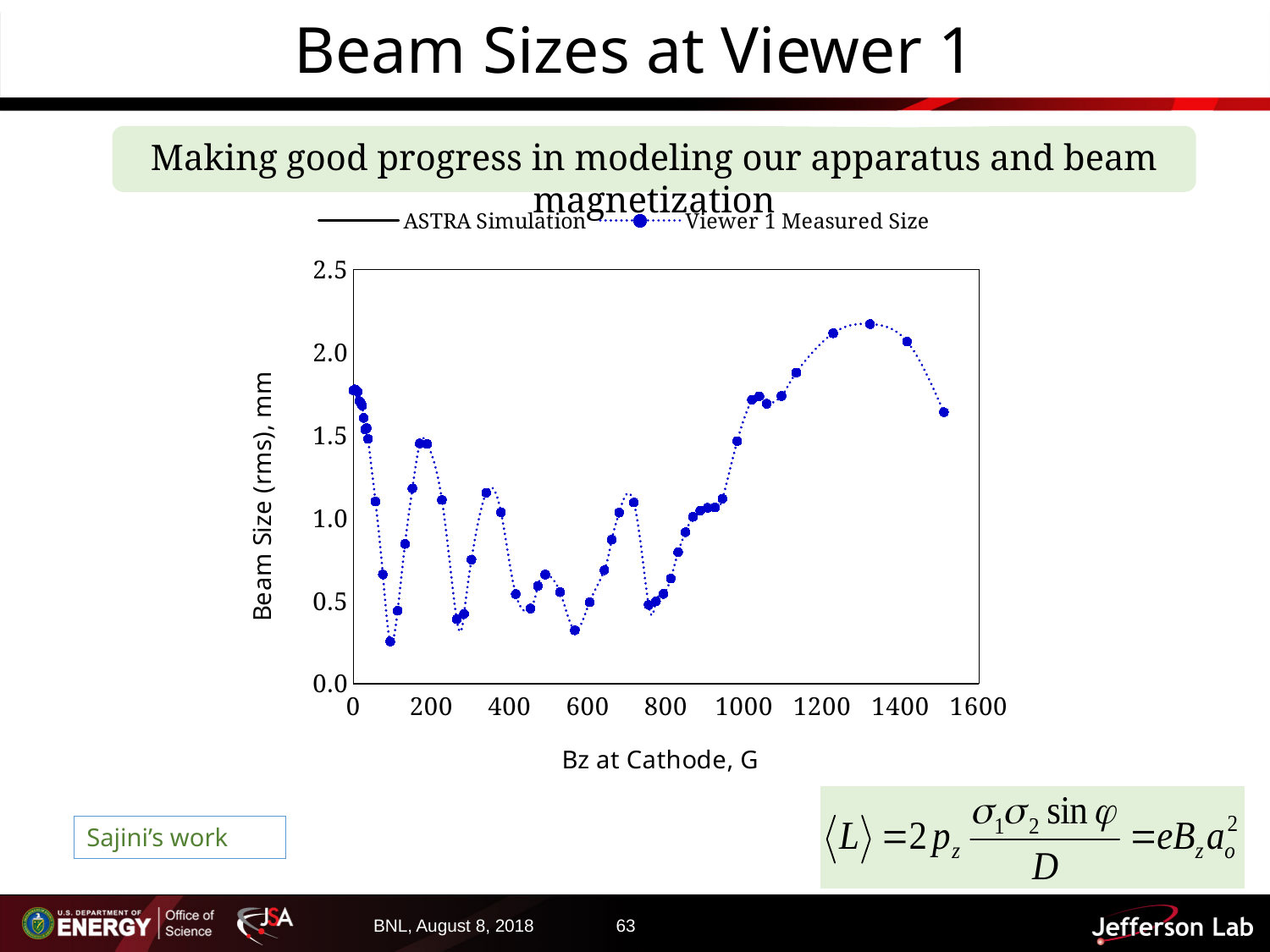
What is the maximum value shown on the y axis of the chart? 2.5 Is the Viewer 1 Measured Size at Bz = 0 G greater or less than 1.5? greater What is the label of the x axis of the chart? Bz at Cathode, G What kind of chart is shown on the slide? Line chart with markers (scatter plot) What are the two series named in the chart legend? ASTRA Simulation and Viewer 1 Measured Size Is the Viewer 1 Measured Size at the last measured point (around 1500 G) greater or less than 1.5? greater Is the lowest Viewer 1 Measured Size value on the chart greater or less than 0.5? less Which is larger, the Viewer 1 Measured Size near Bz = 0 G or near Bz = 1300 G? near 1300 G Does the Viewer 1 Measured Size rise or fall as Bz increases from about 1300 G to about 1500 G? fall How many series does the chart legend list? 2 Does the Viewer 1 Measured Size rise or fall as Bz increases from about 800 G to about 1300 G? rise